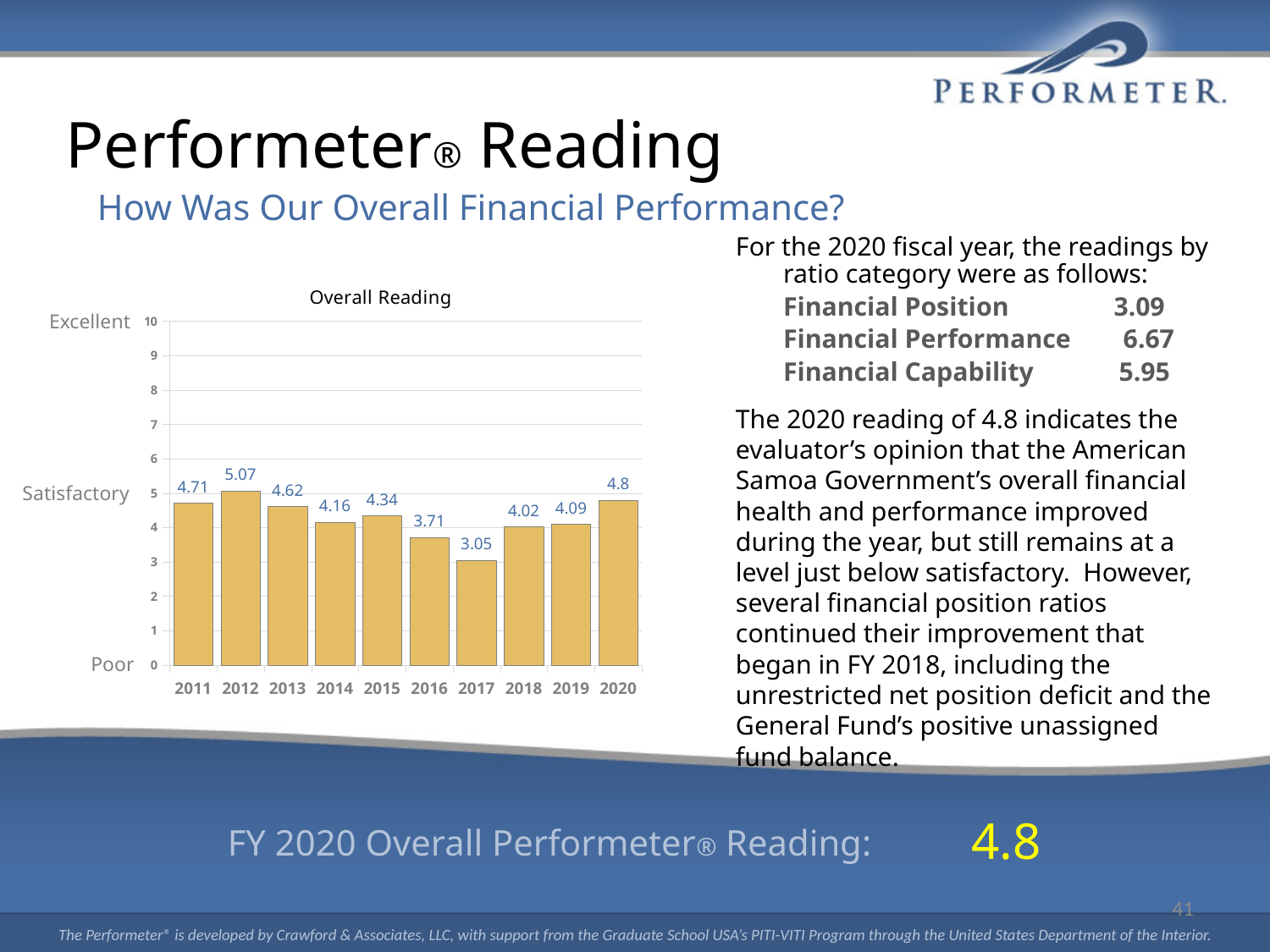
Is the Overall Reading value for 2018 greater or less than 5? less How many years are shown on the x axis of the Overall Reading chart? 10 Does the Overall Reading rise or fall from 2017 to 2020? rise What label appears at the 5 mark on the y axis of the Overall Reading chart? Satisfactory What is the Overall Reading value for 2017? 3.05 What kind of chart is the Overall Reading chart? bar chart Which year has the lowest Overall Reading? 2017 Which year has the highest Overall Reading? 2012 What is the difference between the Overall Reading for 2012 and 2017? 2.02 What is the Overall Reading value for 2012? 5.07 Which year has a higher Overall Reading, 2015 or 2016? 2015 What is the Overall Reading value for 2020? 4.8